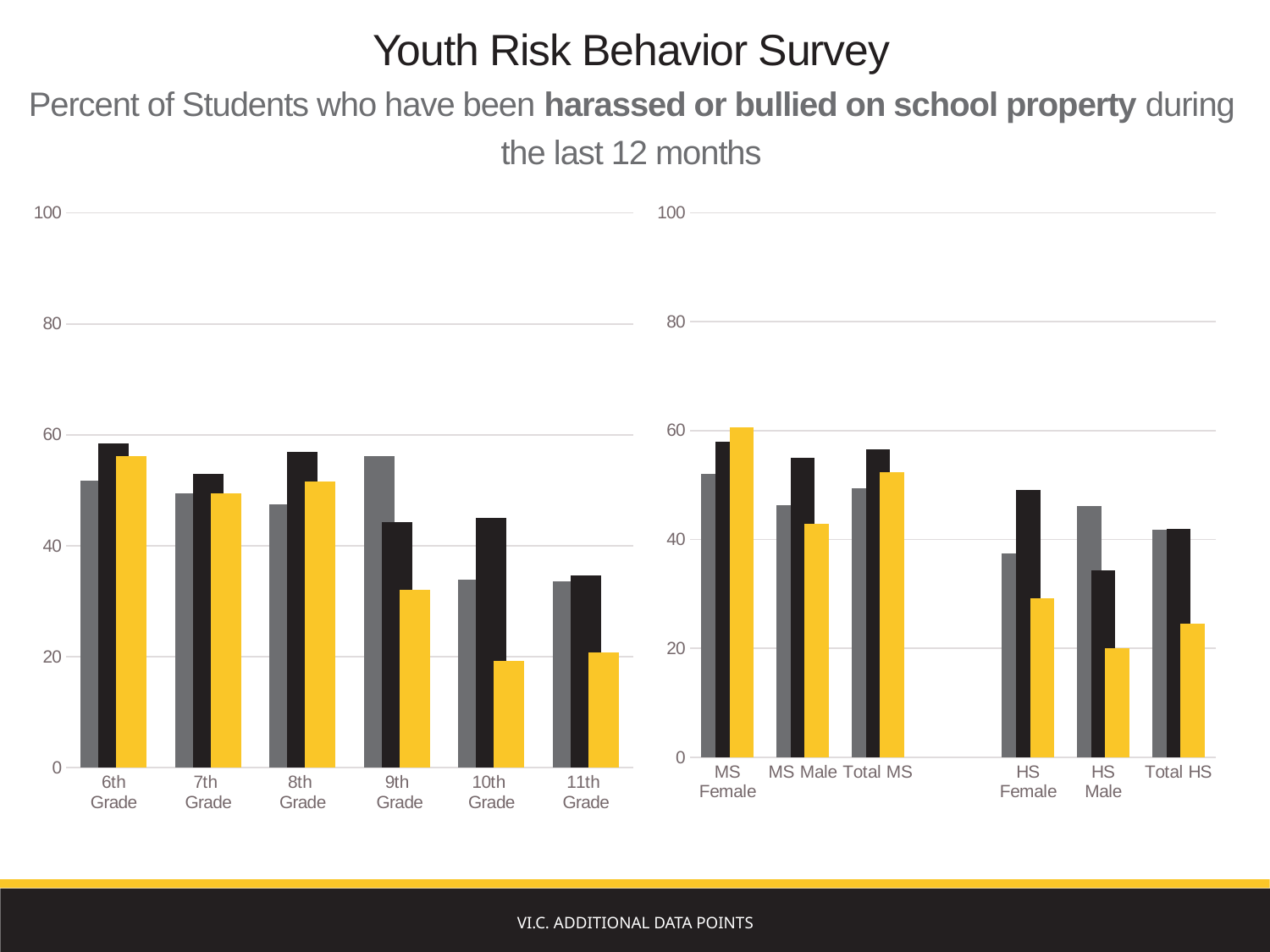
In the left chart, which grade has the tallest yellow bar? 6th Grade In the right chart, is the black bar for HS Female greater or less than 40? greater In the left chart, is the gray bar for 9th Grade greater or less than 40? greater In the right chart, which category has the shortest yellow bar? HS Male What kind of chart is the left chart on the slide? bar chart How many categories are shown on the x axis of the right chart? 6 How many grade categories are shown on the x axis of the left chart? 6 In the right chart, is the gray bar for HS Female greater or less than 40? less In the right chart, which category has the tallest yellow bar? MS Female In the left chart, is the yellow bar for 6th Grade or the yellow bar for 10th Grade larger? 6th Grade